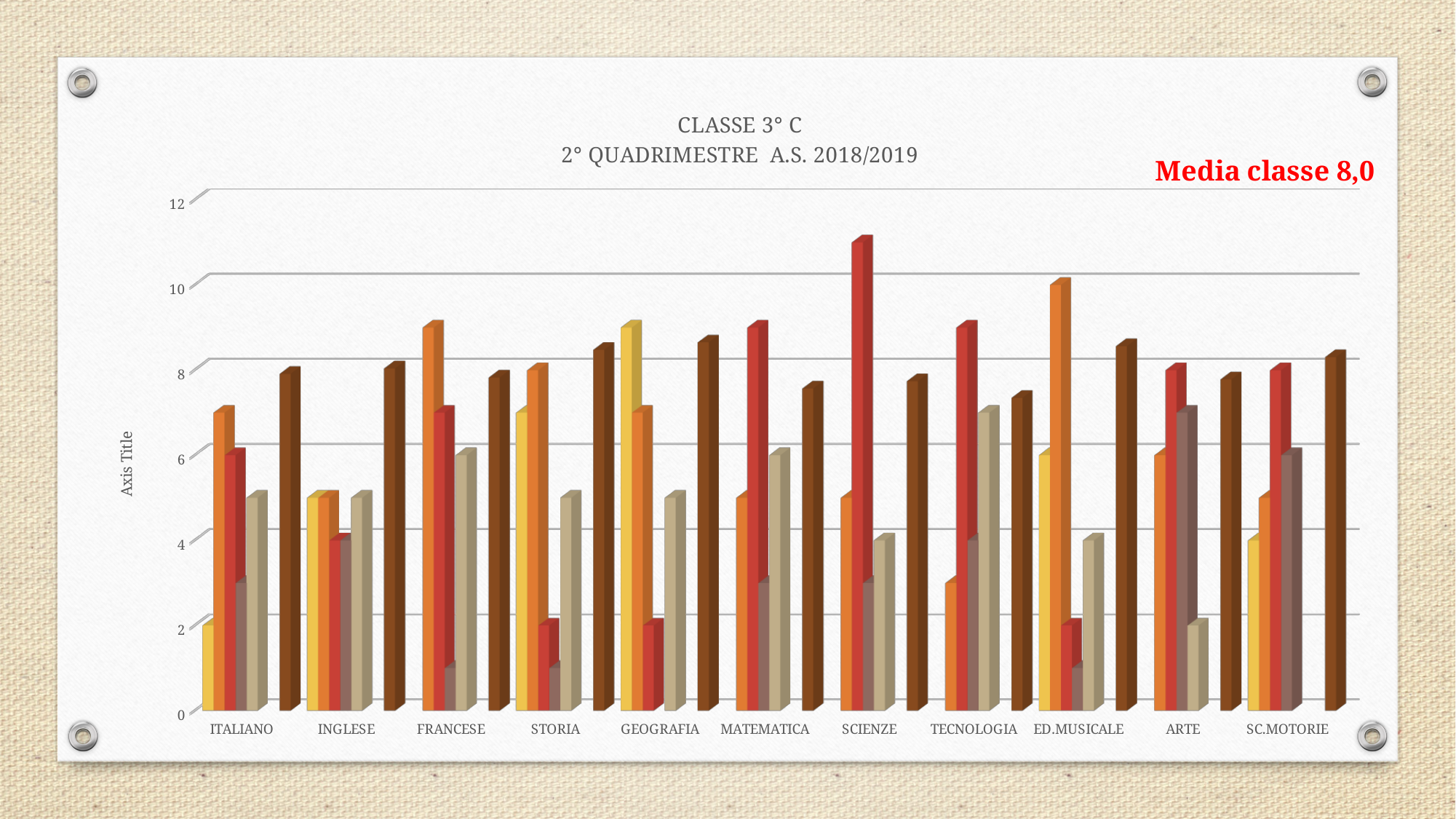
Is the tallest bar for ED.MUSICALE greater or less than 8? greater How many subject categories are shown on the x axis of the chart? 11 What class average is stated in red text on the slide? Media classe 8,0 Is the tallest bar for MATEMATICA greater or less than 8? greater What is the title of the chart? CLASSE 3° C 2° QUADRIMESTRE A.S. 2018/2019 Is the shortest bar for ITALIANO greater or less than 4? less What kind of chart is shown on the slide? bar chart Which category contains the tallest bar on the chart? SCIENZE